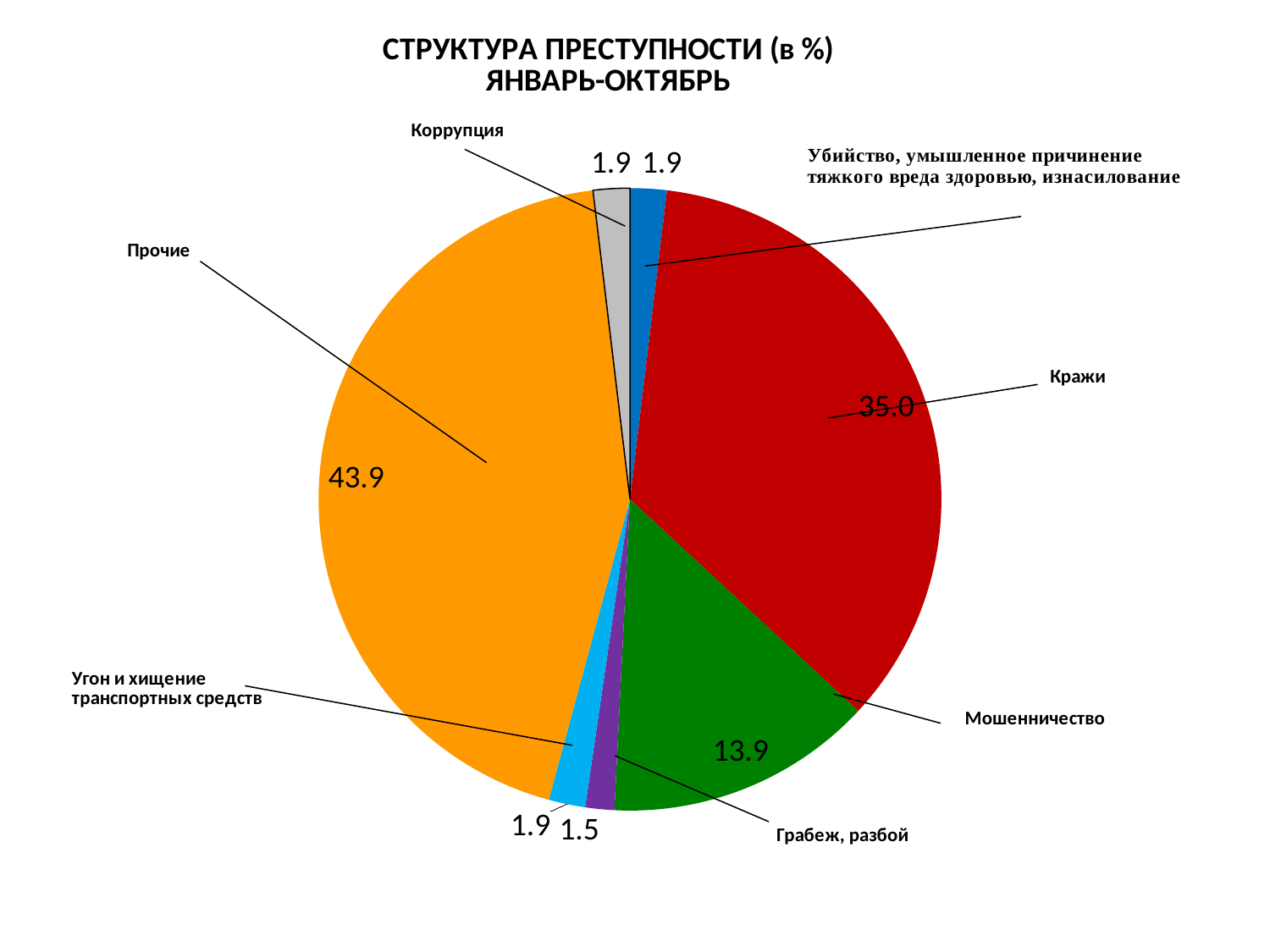
How many slices does the pie chart have? 7 Which is larger, the value for Кражи or the value for Мошенничество? Кражи What is the value for Коррупция? 1.9 What is the value for Мошенничество? 13.9 Which category has the smallest slice of the pie? Грабеж, разбой Which category has the largest slice of the pie? Прочие What is the difference between the values for Прочие and Кражи? 8.9 What is the value for Прочие? 43.9 What is the value for Грабеж, разбой? 1.5 What kind of chart is shown on the slide? Pie chart What is the title of the chart? СТРУКТУРА ПРЕСТУПНОСТИ (в %) ЯНВАРЬ-ОКТЯБРЬ What is the value for Кражи? 35.0